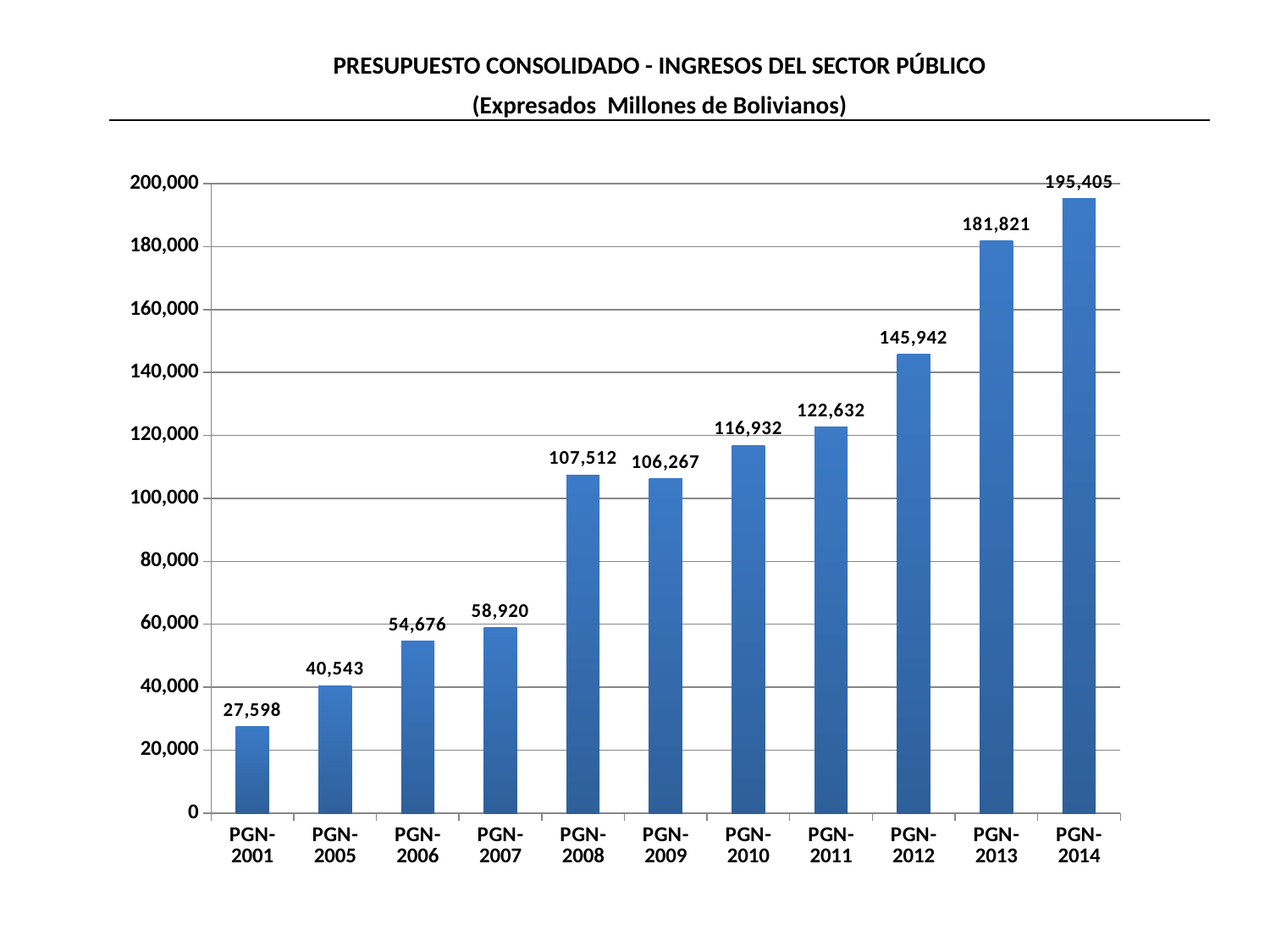
What kind of chart is shown on the slide? bar chart Which is larger, the value for PGN-2010 or the value for PGN-2011? PGN-2011 What is the value for PGN-2008? 107,512 What is the difference between the values for PGN-2008 and PGN-2009? 1,245 What is the value for PGN-2001? 27,598 In what unit are the values expressed, according to the chart subtitle? Millones de Bolivianos How many categories are shown on the x axis? 11 What is the value for PGN-2012? 145,942 Which category has the highest value? PGN-2014 What is the difference between the values for PGN-2014 and PGN-2013? 13,584 Is the value for PGN-2007 greater or less than 60,000? less Which category has the lowest value? PGN-2001